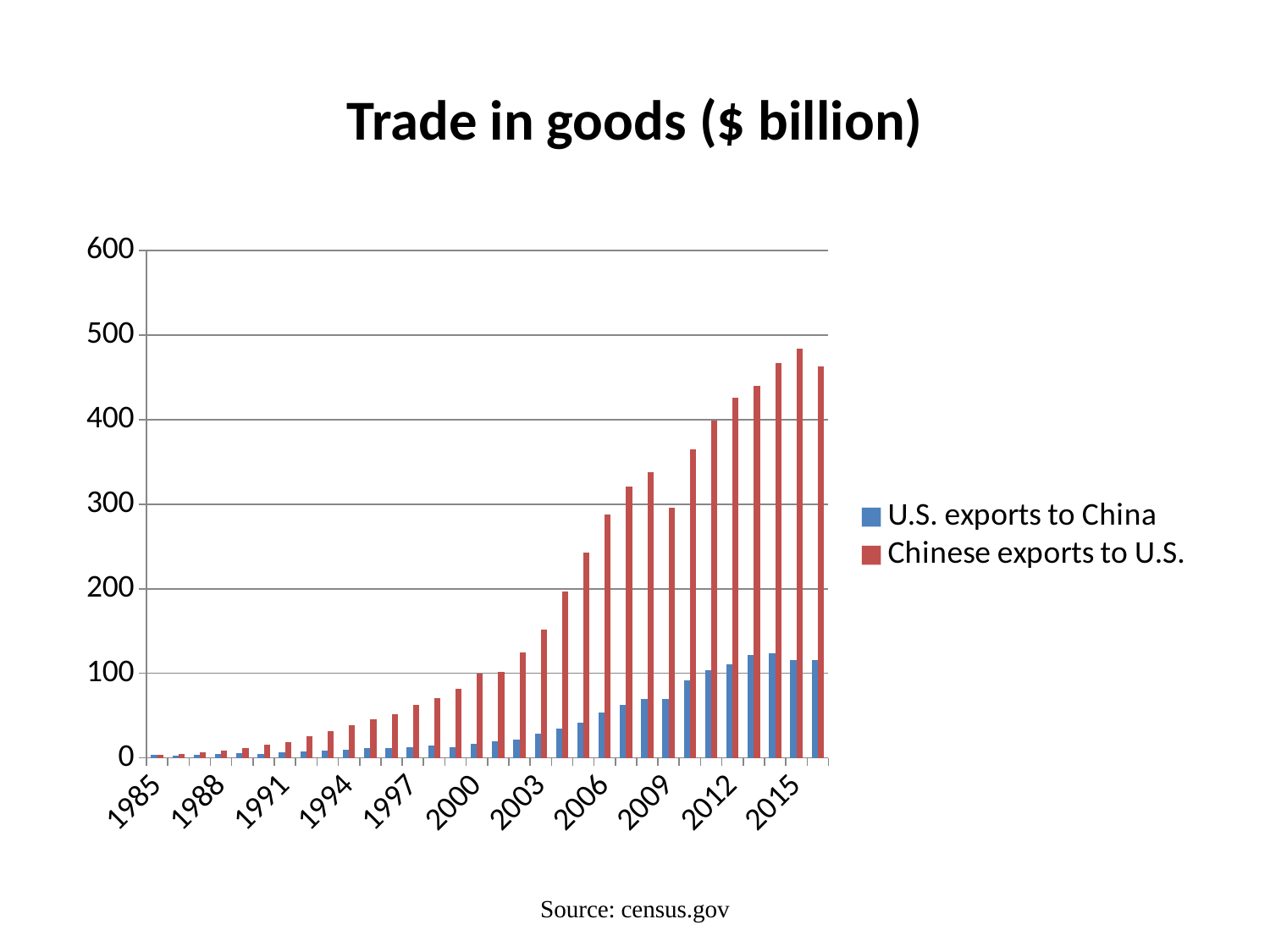
What kind of chart is shown on the slide? Bar chart Do Chinese exports to U.S. generally rise or fall from 1985 to 2015? Rise Is the value of Chinese exports to U.S. in 1997 greater or less than 100? less What is the title of the chart? Trade in goods ($ billion) What are the two series named in the legend? U.S. exports to China; Chinese exports to U.S. Is the value of Chinese exports to U.S. in 2015 greater or less than 400? greater How many year labels are shown on the x axis? 11 Is the value of U.S. exports to China in 2015 greater or less than 200? less In 2015, which is larger: U.S. exports to China or Chinese exports to U.S.? Chinese exports to U.S. How many series does the legend list? 2